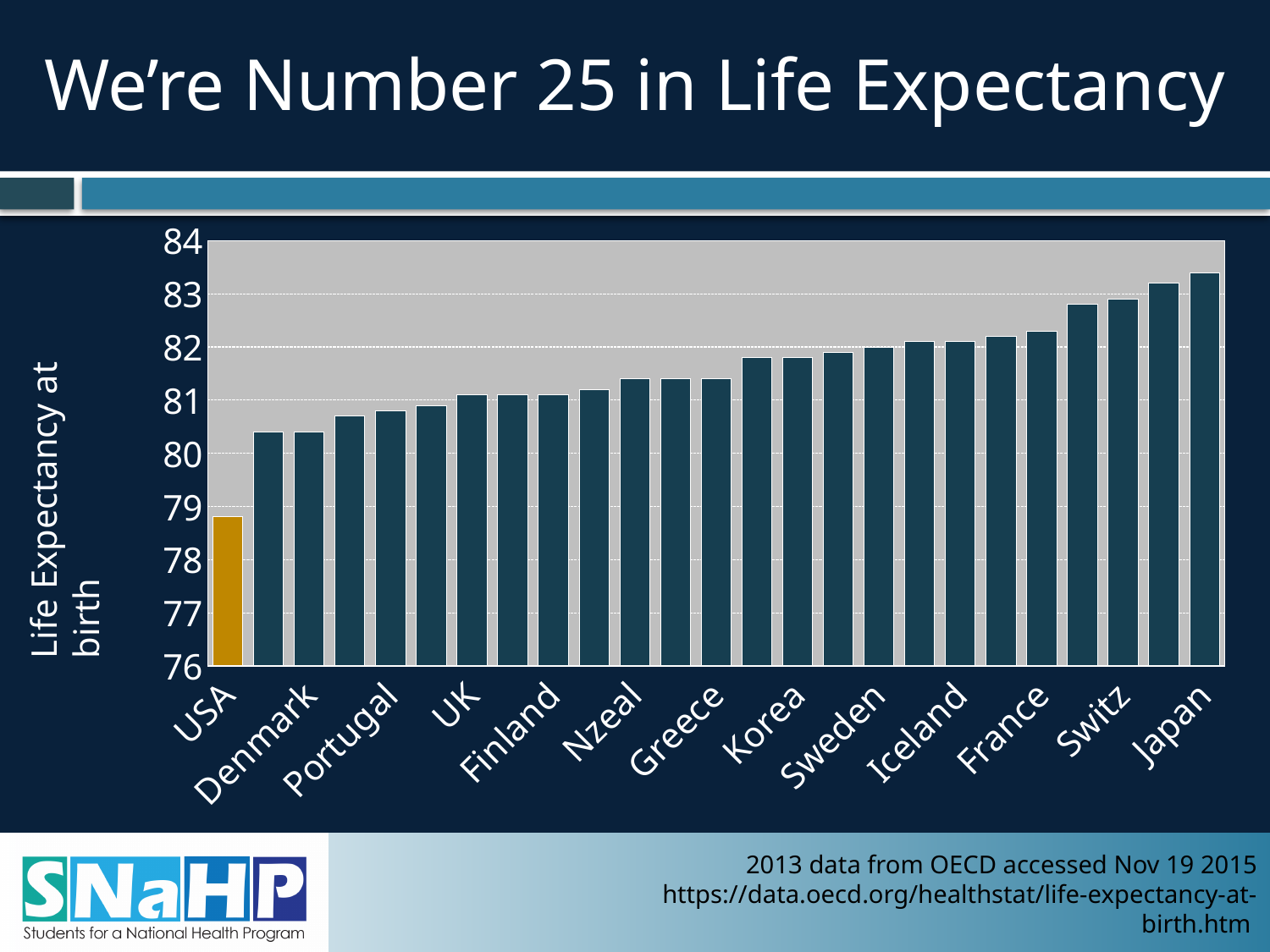
Which has a higher life expectancy at birth, Korea or Denmark? Korea Which bar is shown in a different colour (gold) from the rest? USA Which country has the highest life expectancy at birth in the chart? Japan Is the value for Japan greater or less than 83? greater How many bars are plotted in the chart? 25 Is the value for USA greater or less than 78? greater Which country has the lowest life expectancy at birth in the chart? USA Do the bar values rise or fall moving from left to right along the x axis? rise Is the value for Switz greater or less than 82? greater What kind of chart is shown on the slide? bar chart